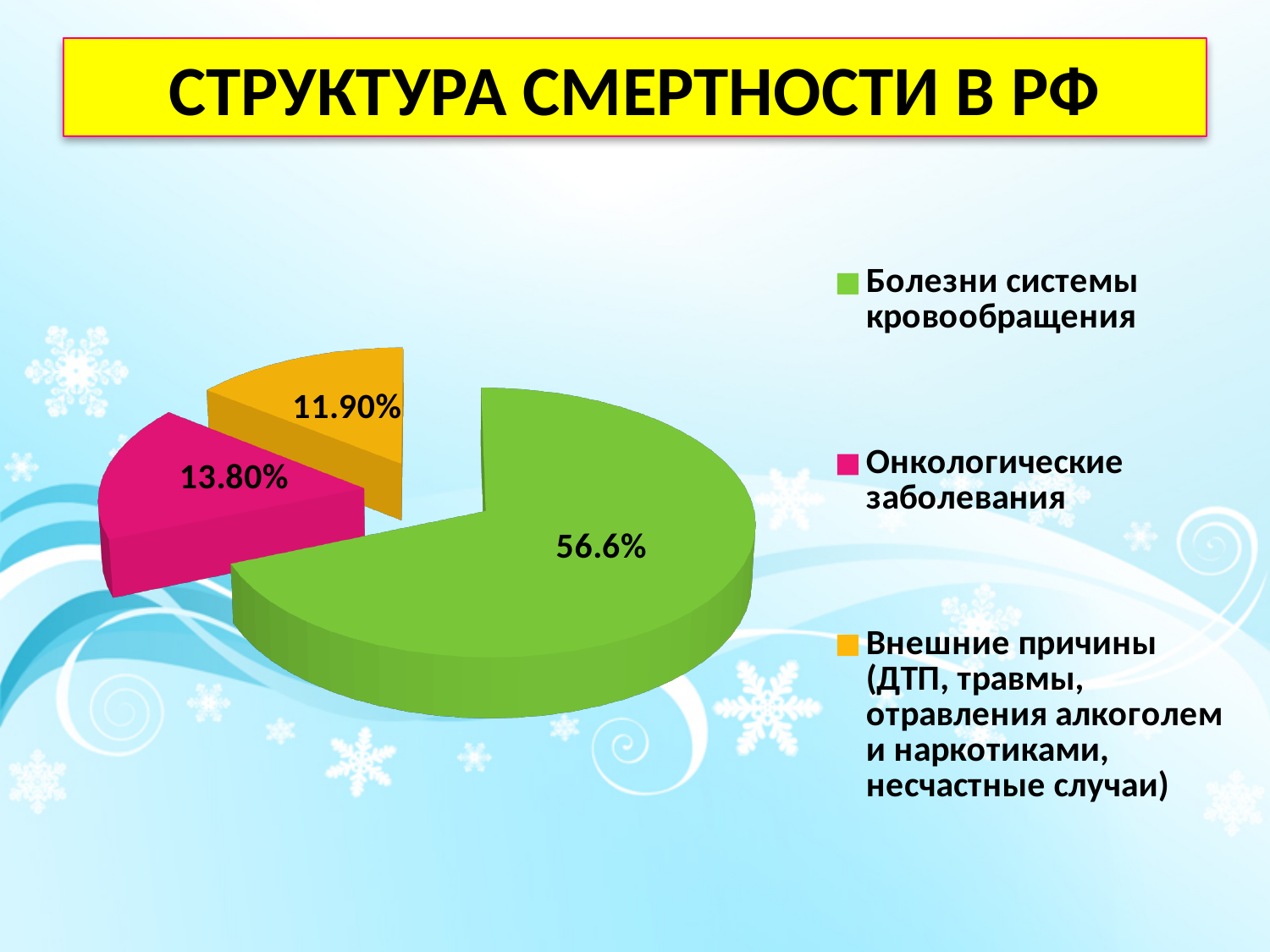
Which is larger: the value for Онкологические заболевания or the value for Внешние причины? Онкологические заболевания What value is shown for Онкологические заболевания? 13.80% What is the title of the slide containing the chart? СТРУКТУРА СМЕРТНОСТИ В РФ What type of chart is shown on the slide? pie chart What share of the pie is labelled for Болезни системы кровообращения? 56.6% What is the difference between the value for Болезни системы кровообращения and the value for Онкологические заболевания? 42.8% How many entries does the legend list? 3 How many slices does the pie chart have? 3 What value is shown for Внешние причины (ДТП, травмы, отравления алкоголем и наркотиками, несчастные случаи)? 11.90% What is the difference between the value for Онкологические заболевания and the value for Внешние причины? 1.90% Which category has the largest slice of the pie? Болезни системы кровообращения Which category has the smallest slice of the pie? Внешние причины (ДТП, травмы, отравления алкоголем и наркотиками, несчастные случаи)